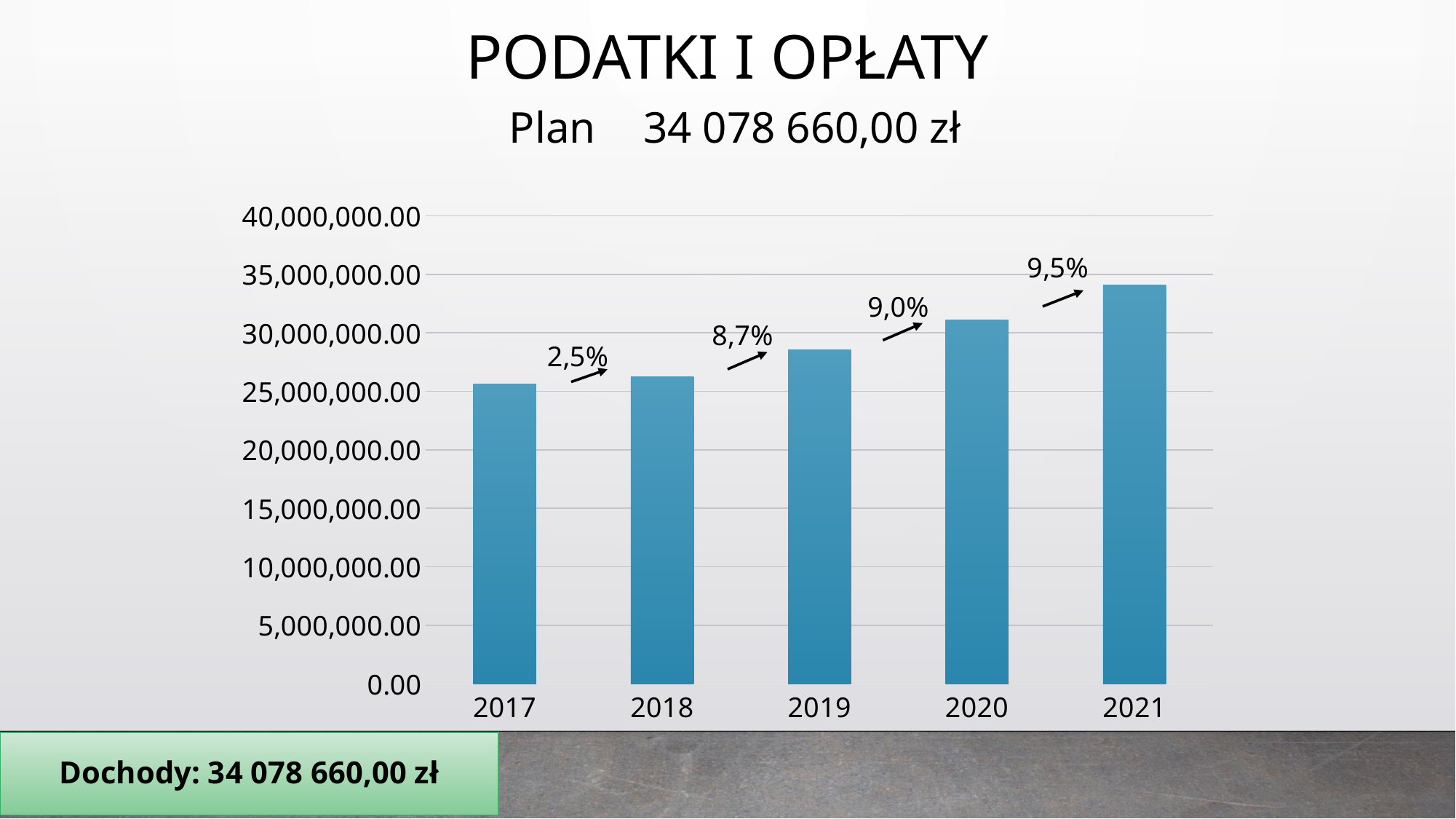
Which is larger, the value for 2019 or the value for 2018? 2019 What plan amount is stated in the chart's subtitle? 34 078 660,00 zł Do the bar values rise or fall from 2017 to 2021? rise Is the value for 2019 greater or less than 30,000,000.00? less Is the value for 2017 greater or less than 30,000,000.00? less Which year has the highest bar in the chart? 2021 Which year has the lowest bar in the chart? 2017 What percentage change is annotated between the 2017 and 2018 bars? 2,5% How many years are shown on the x axis of the chart? 5 What kind of chart is shown on the slide? bar chart What percentage change is annotated between the 2020 and 2021 bars? 9,5% Is the value for 2021 greater or less than 30,000,000.00? greater